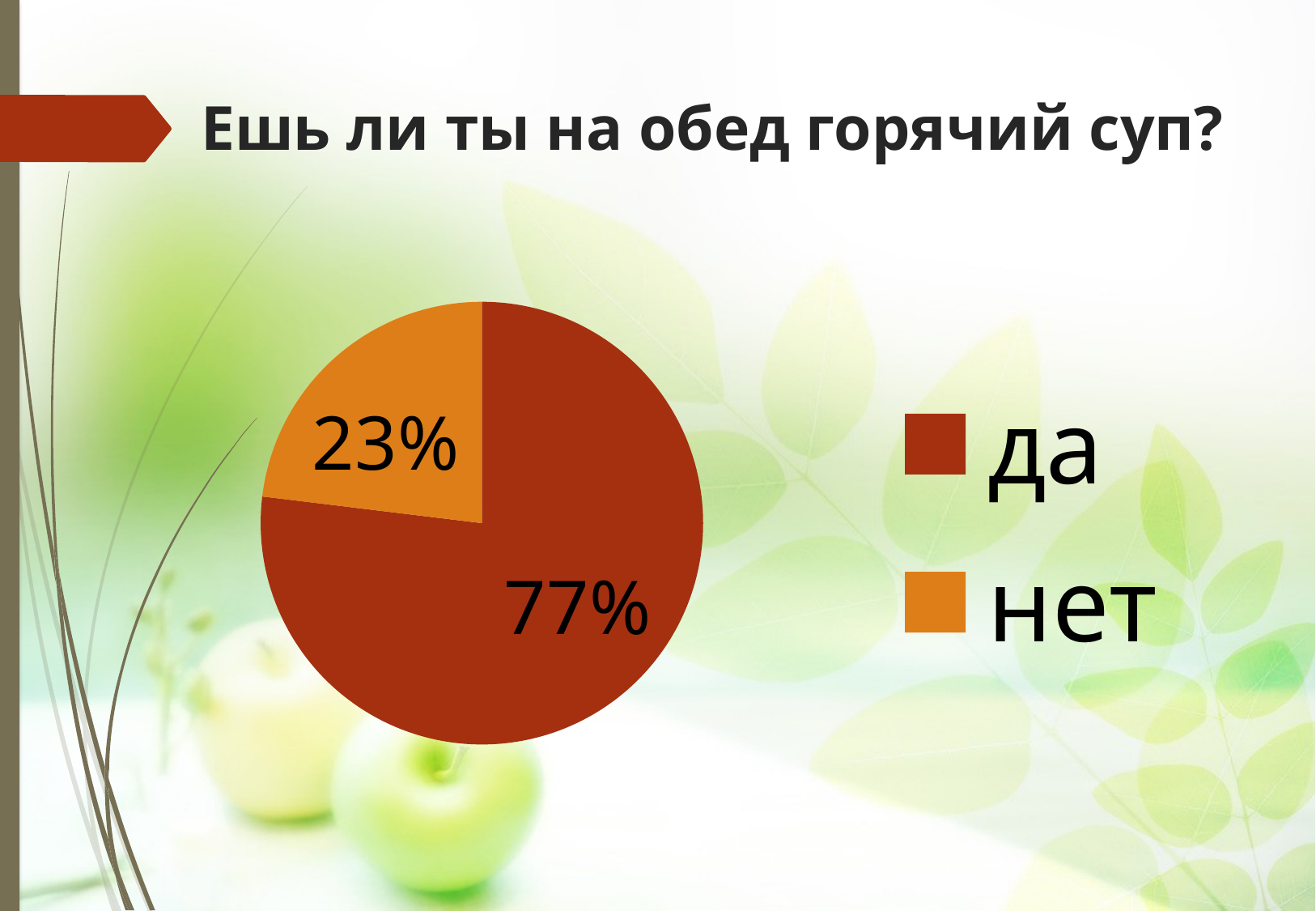
How many slices does the pie chart have? 2 Which category has the largest share of the pie? да What colour is the "нет" slice in the pie chart? orange How many entries does the legend list? 2 What is the difference in percentage points between the "да" and "нет" slices? 54 What kind of chart is shown on the slide? pie chart What share of the pie does the "да" slice take? 77% What is the title of the slide above the chart? Ешь ли ты на обед горячий суп? Which category has the smallest share of the pie? нет Which slice is larger, "да" or "нет"? да What percentage of the pie is labelled "да"? 77% What percentage of the pie is labelled "нет"? 23%